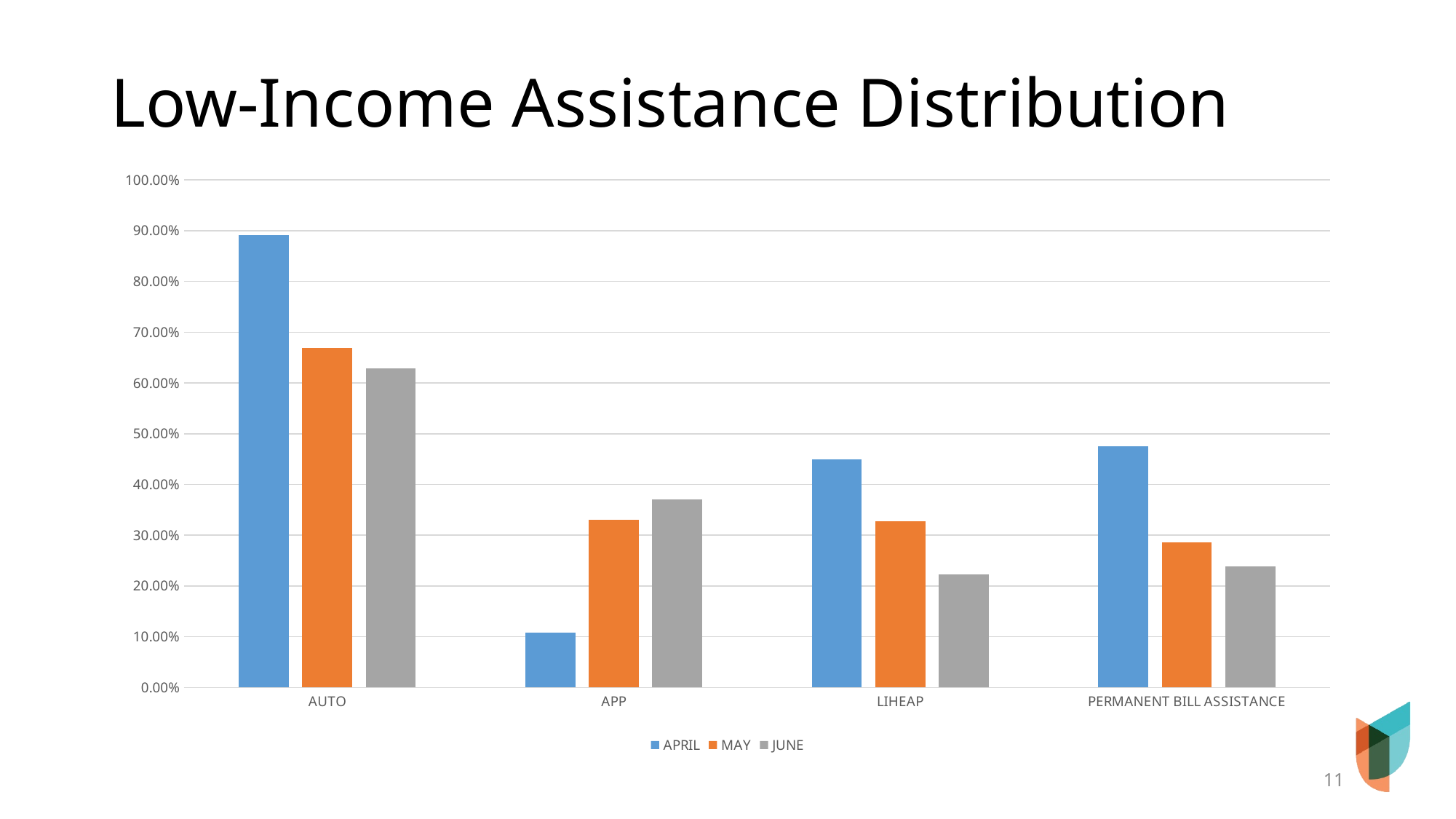
What is the title of the slide? Low-Income Assistance Distribution Which category has the highest APRIL value? AUTO Which category has the lowest APRIL value? APP Is the JUNE value for LIHEAP greater or less than 30.00%? less Is the APRIL value for APP greater or less than 20.00%? less What kind of chart is shown on the slide? bar chart How many categories are shown on the x axis of the chart? 4 Which is larger: the APRIL value for AUTO or the APRIL value for LIHEAP? AUTO For AUTO, do the values rise or fall from APRIL to JUNE? fall How many series does the legend list? 3 Is the APRIL value for AUTO greater or less than 80.00%? greater For APP, which is larger: the MAY value or the JUNE value? JUNE